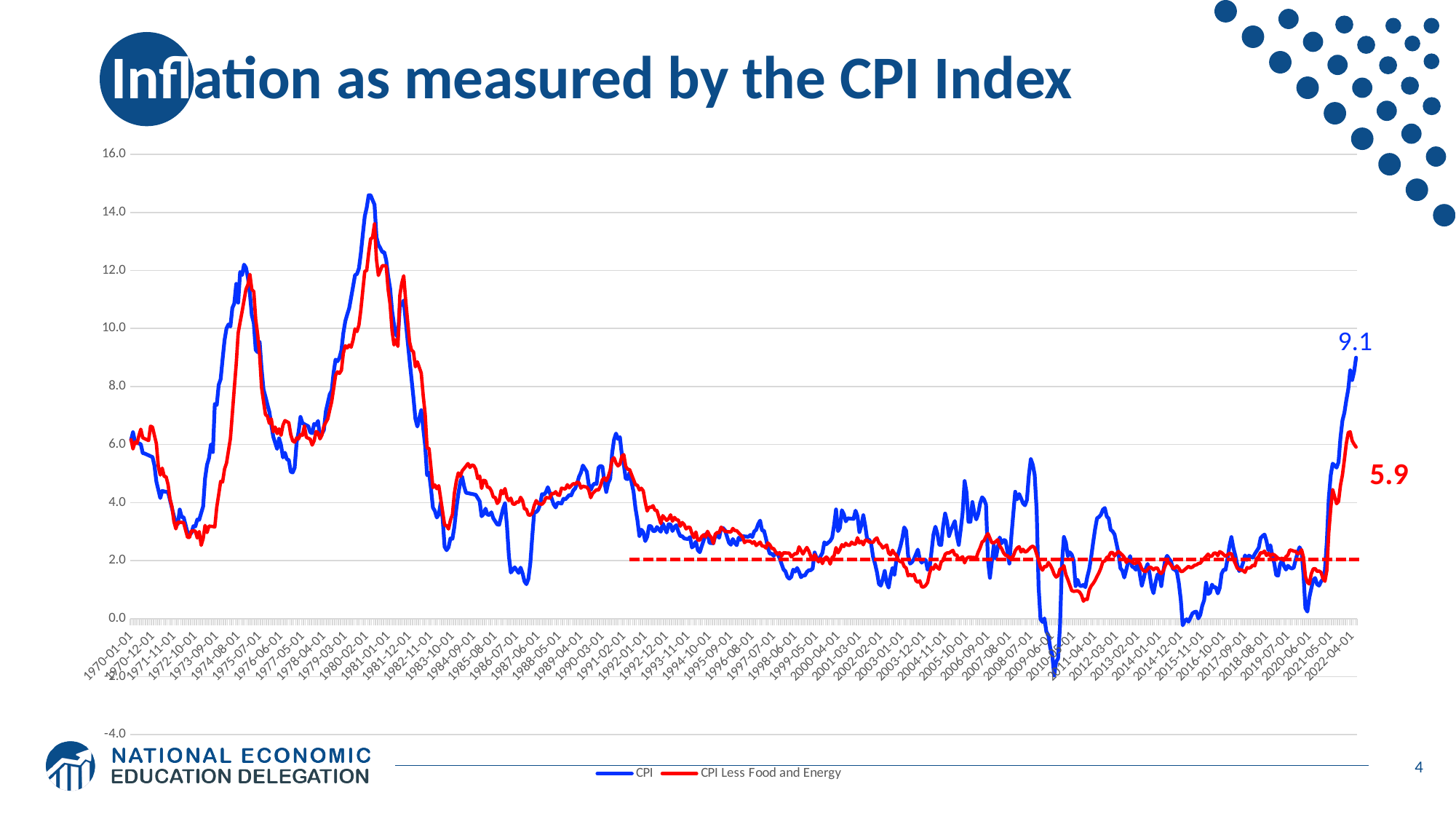
Which series reaches the highest value anywhere on the chart? CPI Is the peak value of the CPI series around 1980 greater or less than 14.0? greater What is the labelled value of the CPI Less Food and Energy series at the end of the chart (2022)? 5.9 What is the difference between the labelled end values of CPI (9.1) and CPI Less Food and Energy (5.9)? 3.2 What kind of chart is shown on the slide? line chart At the end of the chart, which series has the higher labelled value, CPI or CPI Less Food and Energy? CPI What is the labelled value of the CPI series at the end of the chart (2022)? 9.1 Is the peak value of the CPI Less Food and Energy series around 1980 greater or less than 12.0? greater How many series does the legend list? 2 Is the lowest value of the CPI series around 2009 greater or less than 0.0? less At what y-axis level is the dashed horizontal red line drawn? 2.0 What is the title of the chart? Inflation as measured by the CPI Index